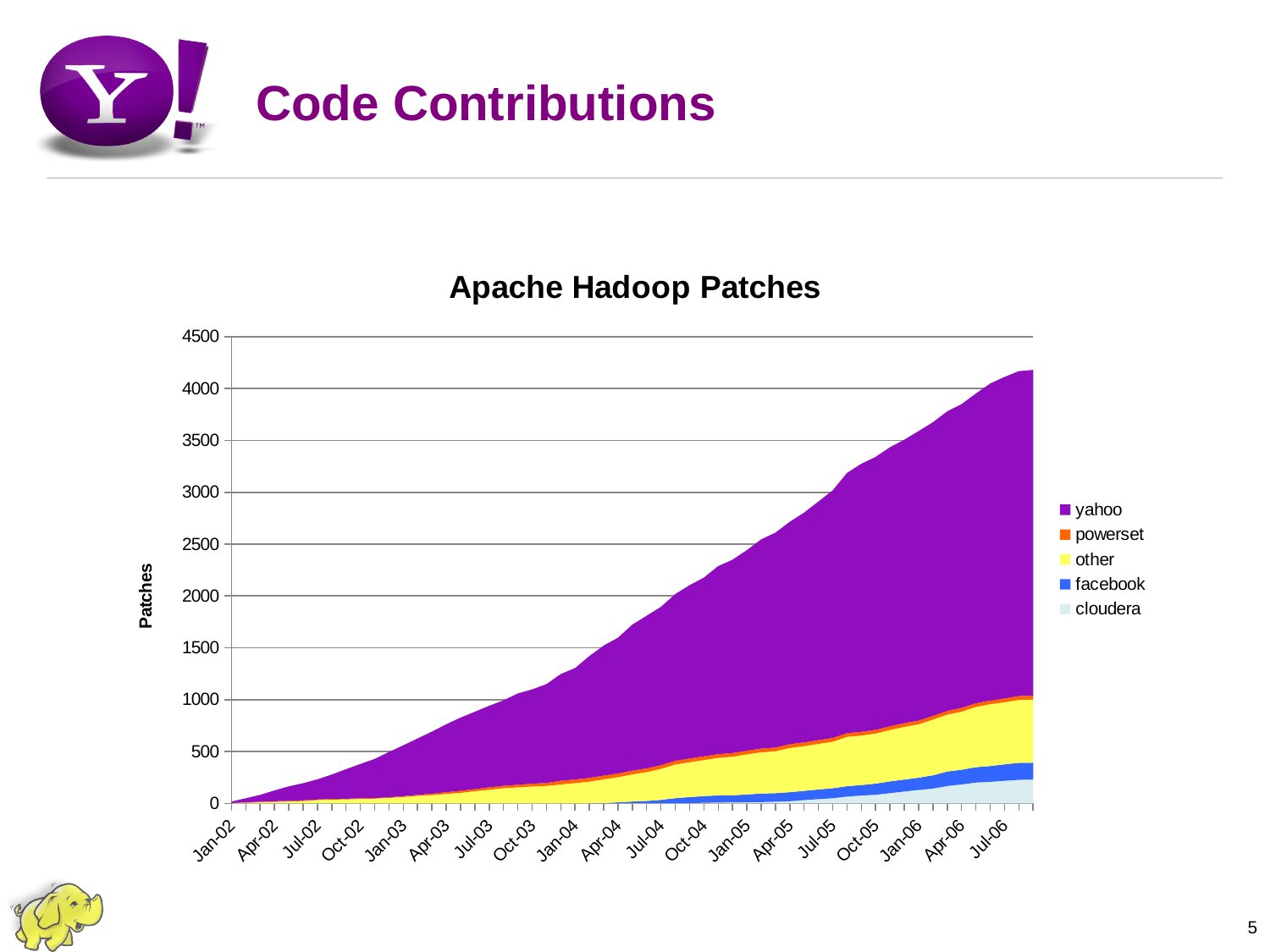
What is the title of the chart? Apache Hadoop Patches What is the label on the vertical axis of the chart? Patches How many date labels are shown along the x axis of the chart? 19 What kind of chart is shown on the slide? Stacked area chart Is the total number of patches at Jul-06 greater or less than 4000? greater Which series contributes the largest number of patches in the chart? yahoo Is the total number of patches at Jul-03 greater or less than 500? greater How many series does the legend of the Apache Hadoop Patches chart list? 5 Is the total number of patches at Jan-04 greater or less than 1500? less Do the total patches rise or fall from Jan-02 to Jul-06? Rise Which series contributes the smallest number of patches in the chart? powerset